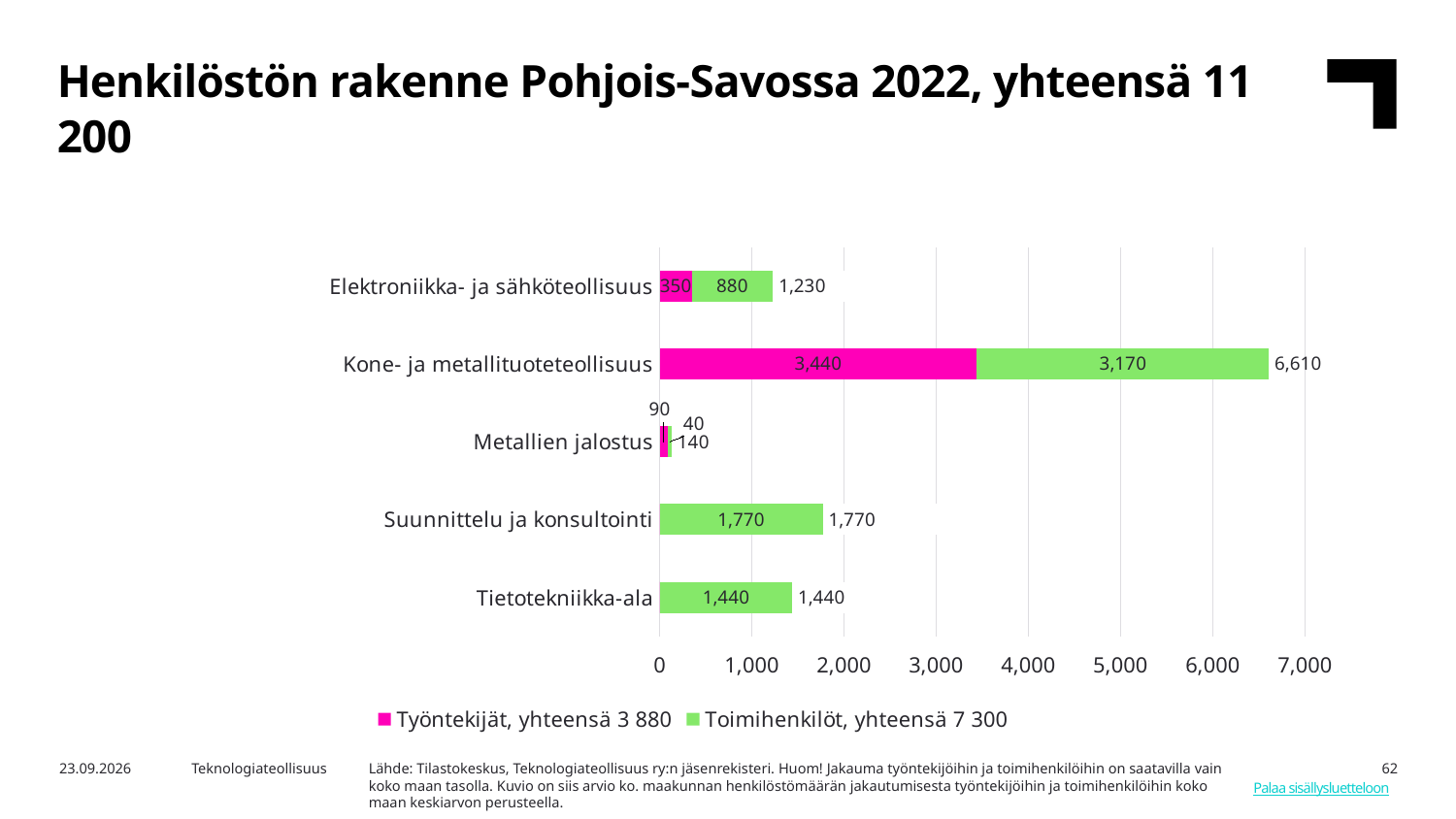
Which category has the highest total? Kone- ja metallituoteteollisuus How many categories are shown on the chart? 5 How many series does the legend list? 2 What is the total of the stacked bar for Metallien jalostus? 140 What is the value for Työntekijät in Kone- ja metallituoteteollisuus? 3,440 What kind of chart is shown on the slide? Bar chart What is the difference between the Työntekijät and Toimihenkilöt values in Kone- ja metallituoteteollisuus? 270 What is the total of the stacked bar for Kone- ja metallituoteteollisuus? 6,610 Which is larger, the total for Suunnittelu ja konsultointi or the total for Tietotekniikka-ala? Suunnittelu ja konsultointi Which category has the lowest total? Metallien jalostus What is the value for Toimihenkilöt in Elektroniikka- ja sähköteollisuus? 880 What is the title of the chart on the slide? Henkilöstön rakenne Pohjois-Savossa 2022, yhteensä 11 200